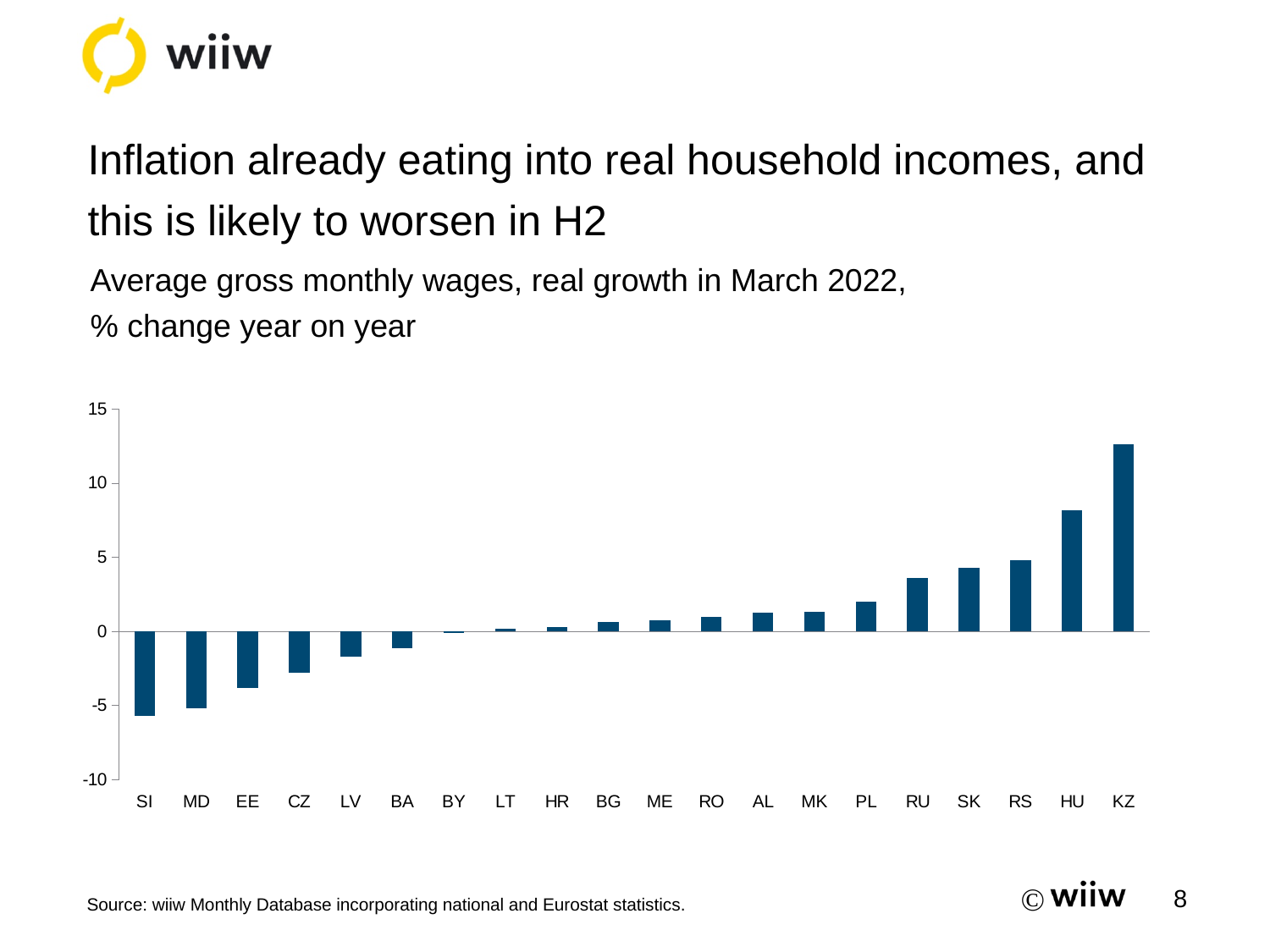
Which has the larger value, CZ or PL? PL Is the value for HU greater or less than 5? greater Is the value for EE greater or less than -5? greater What does the chart subtitle say is being measured? Average gross monthly wages, real growth in March 2022, % change year on year What kind of chart is shown on the slide? Bar chart How many countries are shown on the x axis of the chart? 20 Is the value for KZ greater or less than 10? greater Which has the larger value, HU or RS? HU Which country has the highest value in the chart? KZ Do the values rise or fall moving from left to right along the x axis? Rise